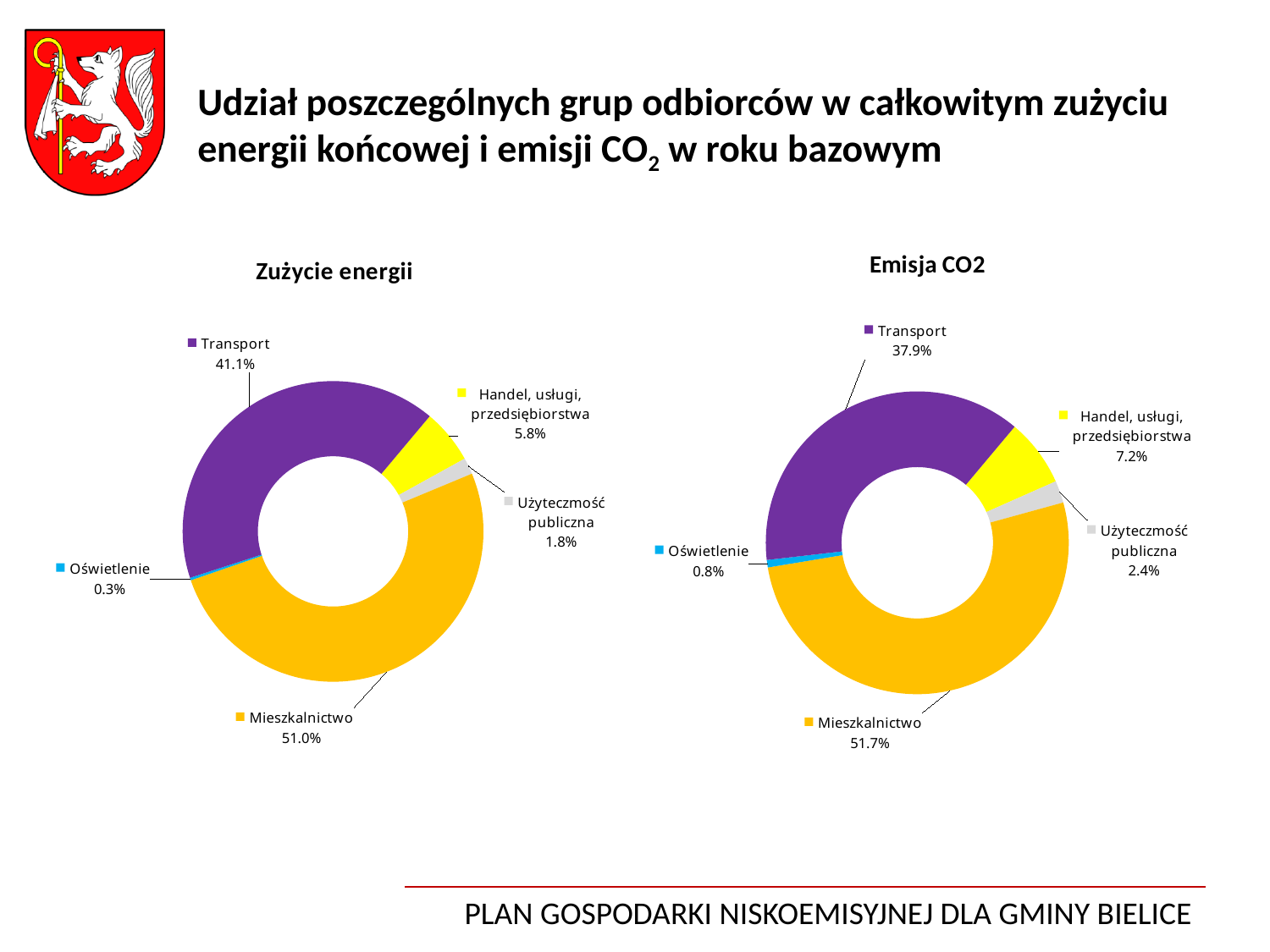
How many categories are shown in the "Zużycie energii" chart? 5 In the "Emisja CO2" chart, what is the difference between Mieszkalnictwo and Transport? 13.8% In the "Emisja CO2" chart, which is larger: Handel, usługi, przedsiębiorstwa or Użyteczmość publiczna? Handel, usługi, przedsiębiorstwa In the "Zużycie energii" chart, what colour is the Mieszkalnictwo slice? Orange/yellow-orange In the "Emisja CO2" chart, which category has the smallest share? Oświetlenie In the "Zużycie energii" chart, what share does Transport have? 41.1% In the "Zużycie energii" chart, what is the value for Oświetlenie? 0.3% In the "Emisja CO2" chart, what share does Mieszkalnictwo have? 51.7% In the "Zużycie energii" chart, what is the difference between Handel, usługi, przedsiębiorstwa and Użyteczmość publiczna? 4.0% In the "Emisja CO2" chart, what is the value for Użyteczmość publiczna? 2.4% In the "Zużycie energii" chart, which category has the largest share? Mieszkalnictwo What type of chart is the "Emisja CO2" chart? Doughnut (pie) chart